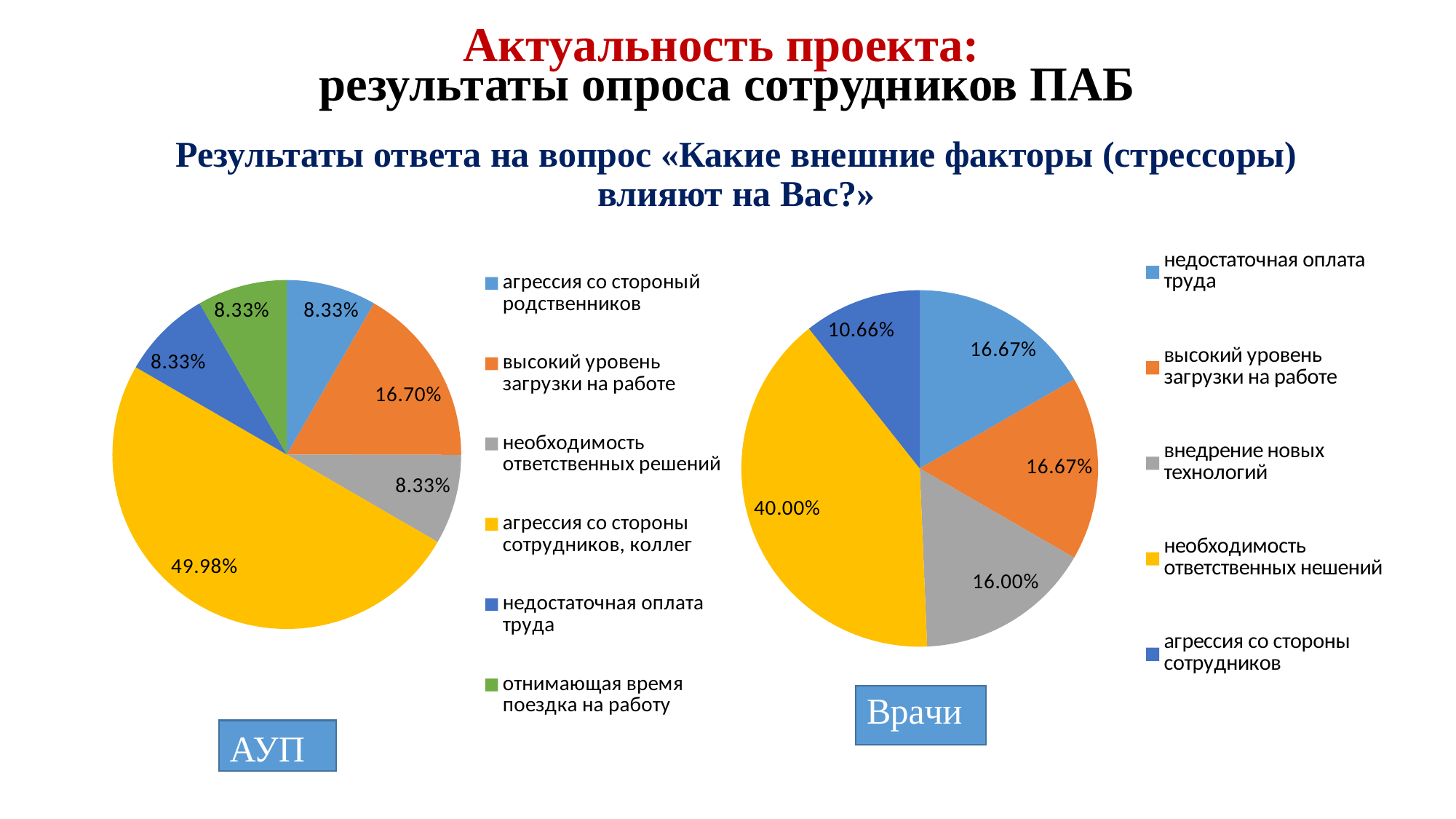
How many categories does the legend of the АУП pie chart list? 6 In the АУП pie chart, what share is labelled for «агрессия со стороны сотрудников, коллег»? 49.98% In the АУП pie chart, what share is labelled for «высокий уровень загрузки на работе»? 16.70% In the Врачи pie chart, which category has the smallest slice? агрессия со стороны сотрудников In the Врачи pie chart, what is the difference between the share for «необходимость ответственных нешений» and the share for «внедрение новых технологий»? 24.00% In the АУП pie chart, which is larger: the slice for «высокий уровень загрузки на работе» or the slice for «необходимость ответственных решений»? высокий уровень загрузки на работе In the Врачи pie chart, what share is labelled for «внедрение новых технологий»? 16.00% How many categories does the legend of the Врачи pie chart list? 5 In the Врачи pie chart, what share is labelled for «агрессия со стороны сотрудников»? 10.66% In the АУП pie chart, which category has the largest slice? агрессия со стороны сотрудников, коллег What type of chart is used for the Врачи data? Pie chart In the Врачи pie chart, what share is labelled for «необходимость ответственных нешений»? 40.00%